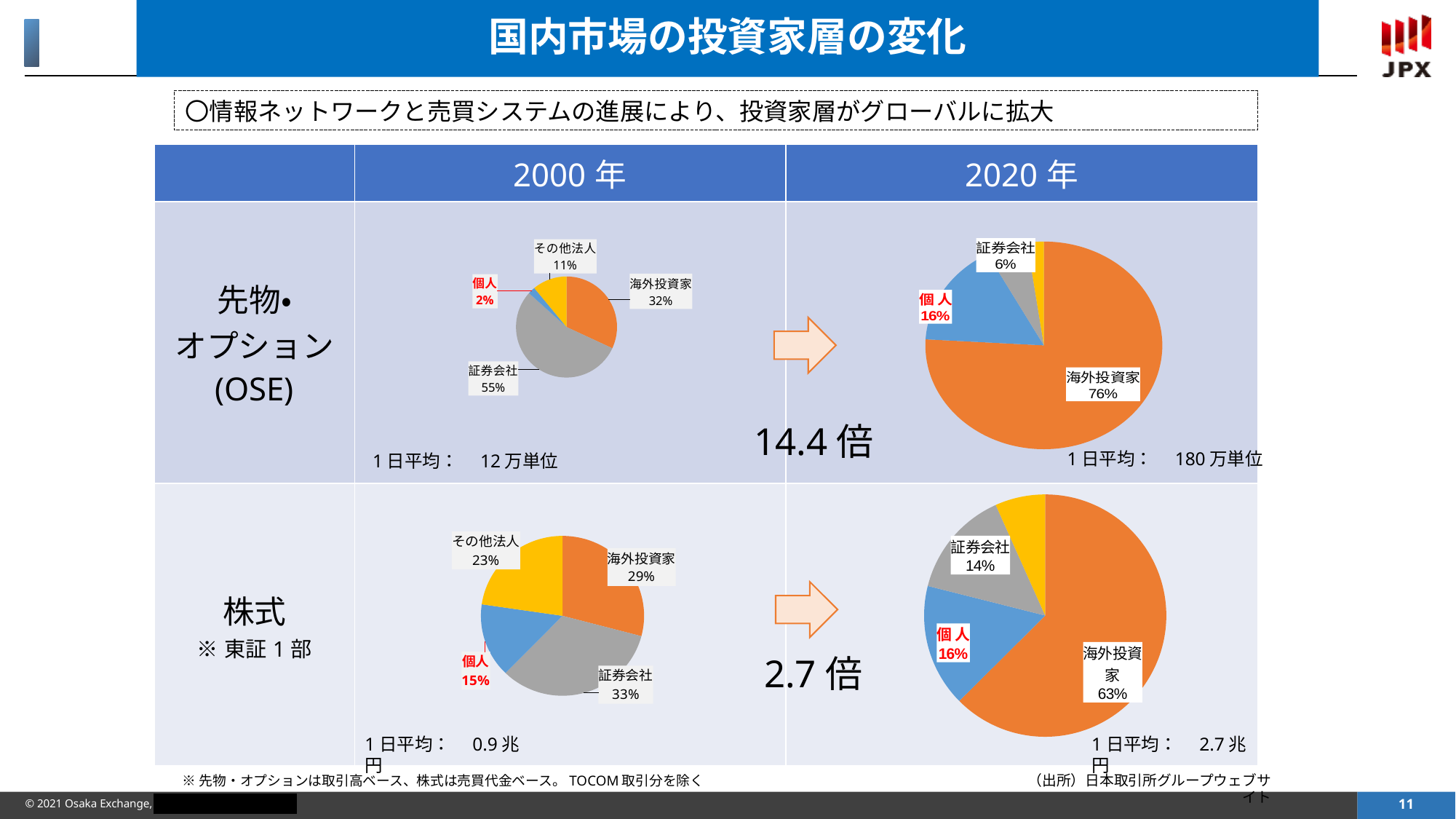
What is the difference between the 海外投資家 share in the 株式 2020年 pie chart and the 海外投資家 share in the 株式 2000年 pie chart? 34 percentage points In the 株式 2000年 pie chart, which is larger: the share for 海外投資家 or the share for 個人? 海外投資家 What kind of chart is used to show the investor composition on this slide? Pie chart In the 先物・オプション (OSE) 2020年 pie chart, what share is labelled for 個人? 16% In the 先物・オプション (OSE) 2000年 pie chart, which labelled category has the smallest share? 個人 In the 先物・オプション (OSE) 2000年 pie chart, which labelled category has the largest share? 証券会社 In the 先物・オプション (OSE) 2000年 pie chart, what share is labelled for 証券会社? 55% In the 株式 2000年 pie chart, which labelled category has the largest share? 証券会社 In the 先物・オプション (OSE) 2000年 pie chart, what share is labelled for 海外投資家? 32% In the 株式 2020年 pie chart, what share is labelled for 証券会社? 14% In the 株式 2000年 pie chart, what share is labelled for その他法人? 23% In the 先物・オプション (OSE) 2020年 pie chart, what share is labelled for 海外投資家? 76%